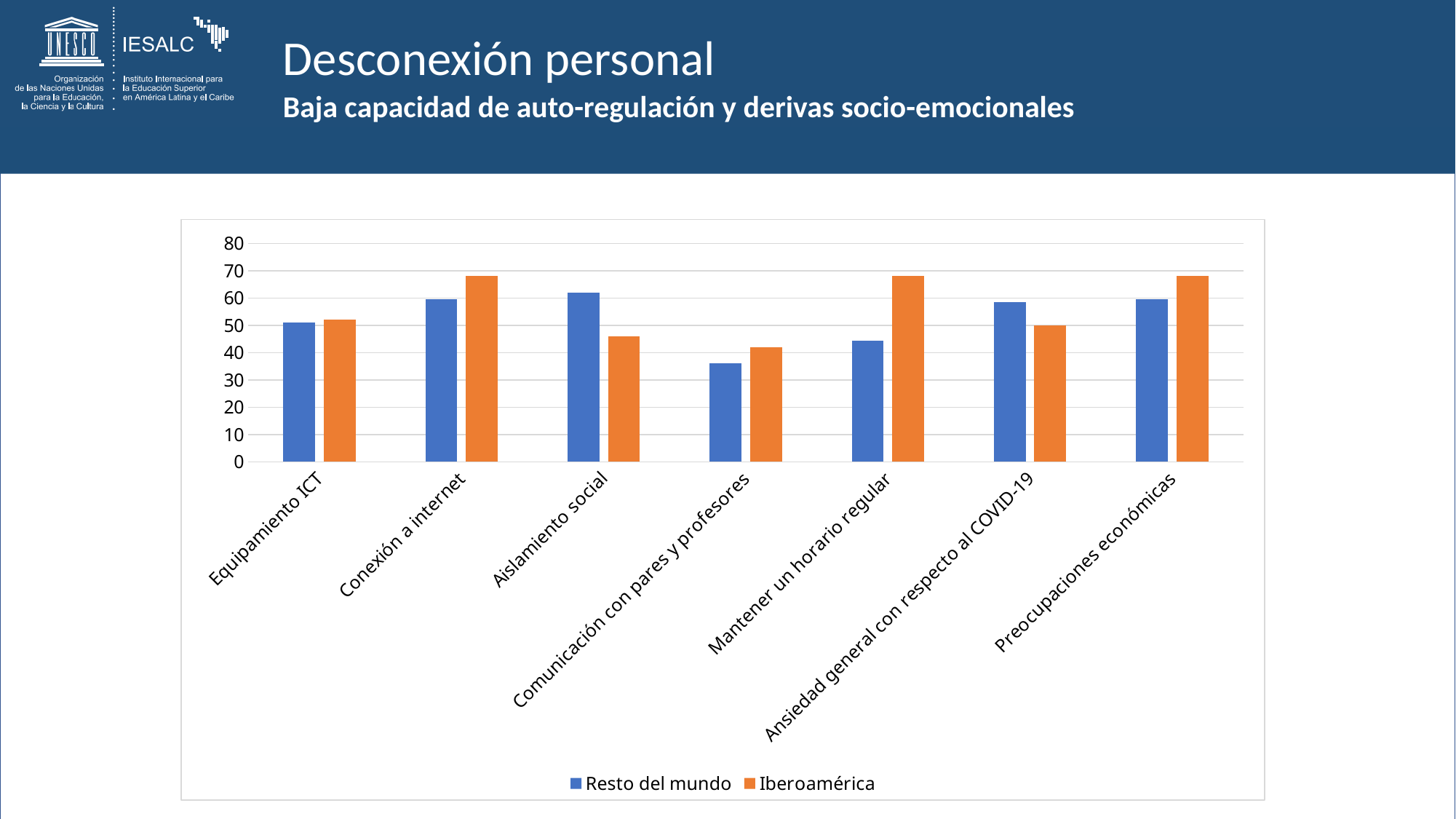
For which category is the Resto del mundo value lowest? Comunicación con pares y profesores For Mantener un horario regular, which series has the larger value, Resto del mundo or Iberoamérica? Iberoamérica Is the Resto del mundo value for Comunicación con pares y profesores greater or less than 40? less For Aislamiento social, which series has the larger value, Resto del mundo or Iberoamérica? Resto del mundo How many series does the legend list? 2 Which series does the orange colour represent in the chart? Iberoamérica For which category is the Iberoamérica value lowest? Comunicación con pares y profesores What kind of chart is shown on the slide? bar chart Is the Iberoamérica value for Mantener un horario regular greater or less than 60? greater For Ansiedad general con respecto al COVID-19, which series has the larger value, Resto del mundo or Iberoamérica? Resto del mundo Is the Iberoamérica value for Aislamiento social greater or less than 50? less How many categories are shown on the x axis of the chart? 7